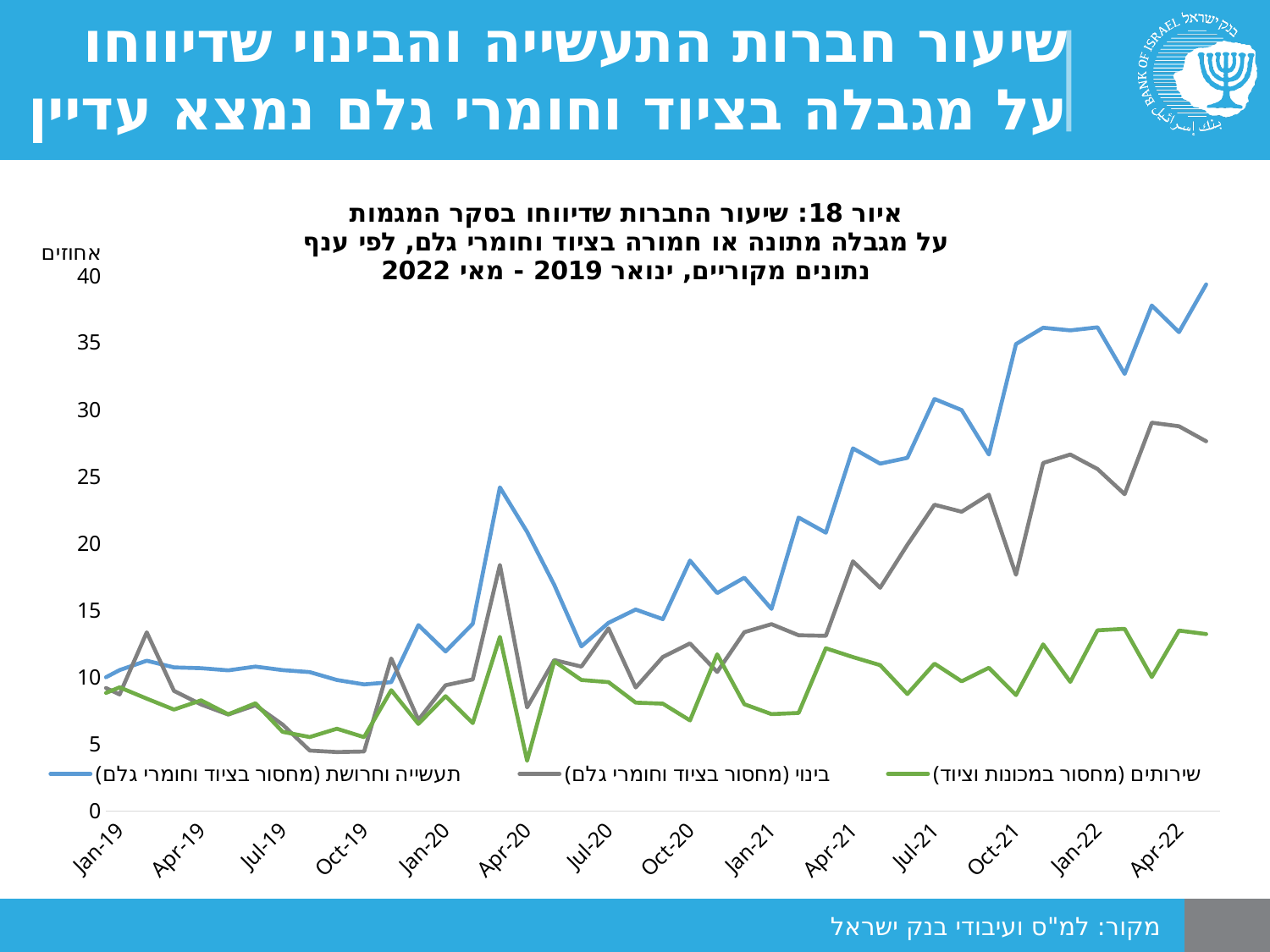
Which series is drawn in green according to the legend? שירותים (מחסור במכונות וציוד) What kind of chart is shown on the slide? line chart What unit label is shown at the top of the y axis? אחוזים At Apr-20, which is larger: the blue series (תעשייה וחרושת) or the gray series (בינוי)? blue (תעשייה וחרושת) How many series does the legend list? 3 At Jan-22, which is larger: the gray series (בינוי) or the green series (שירותים)? gray (בינוי) Is the value of the green series (שירותים) at Oct-19 greater or less than 10? less Which series reaches the highest value anywhere on the chart? תעשייה וחרושת (מחסור בציוד וחומרי גלם) (blue) Which series has the lowest value at Apr-22? שירותים (מחסור במכונות וציוד) (green) Is the peak value of the blue series (תעשייה וחרושת) greater or less than 35? greater Does the blue series (תעשייה וחרושת) generally rise or fall between Jan-21 and Apr-22? rise